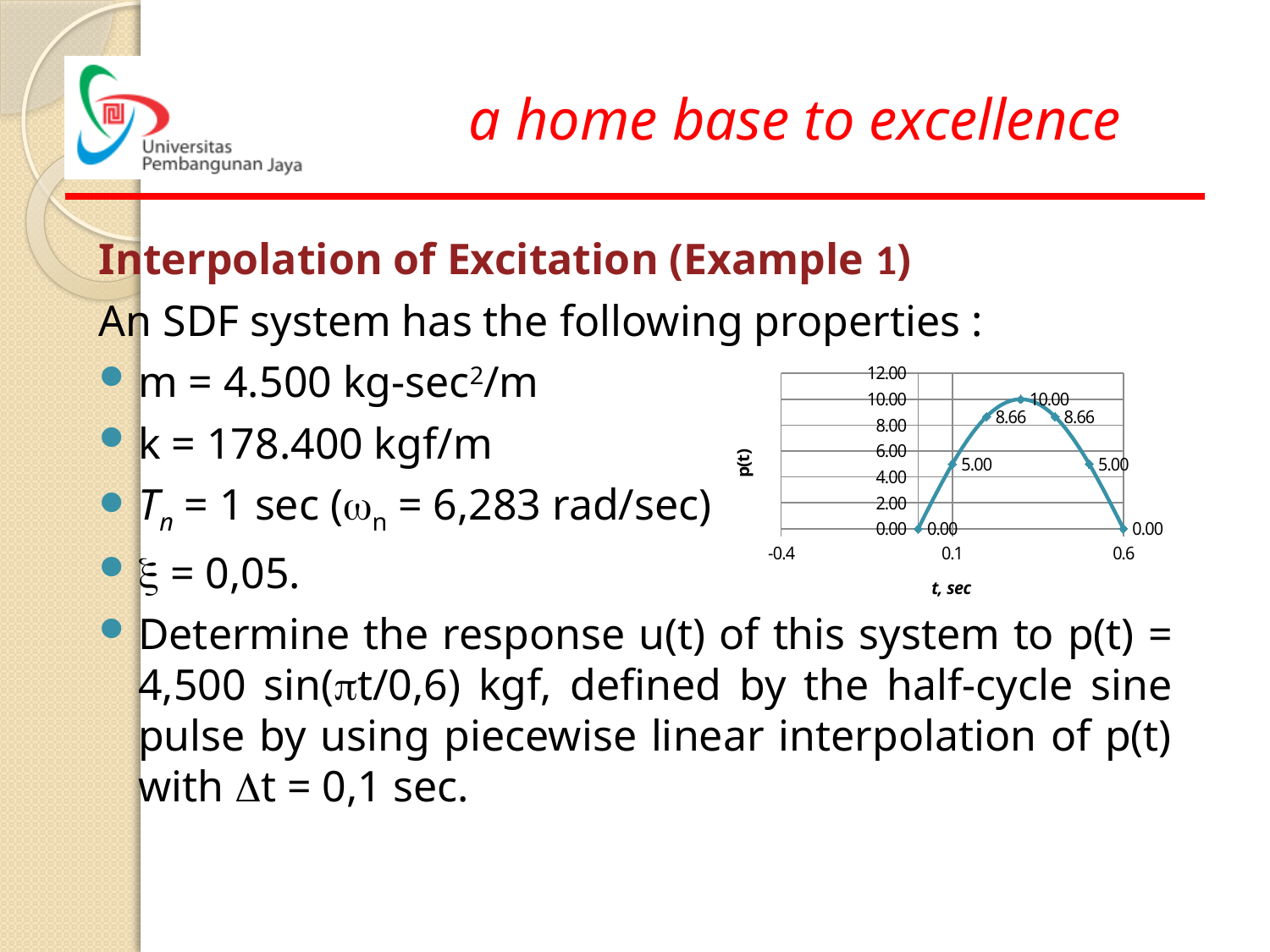
How does p(t) change along the x axis from left to right? rises to a peak then falls What is the difference between the peak value 10.00 and the neighbouring labelled value 8.66? 1.34 What is the label of the horizontal axis of the chart? t, sec What is the highest tick value shown on the vertical axis? 12.00 How many data points are plotted on the chart? 7 What is the difference between the labelled values 8.66 and 5.00? 3.66 What is the label of the vertical axis of the chart? p(t) Which is larger, the labelled value 8.66 or the labelled value 5.00? 8.66 What is the highest value labelled on the chart? 10.00 Is the peak value of the curve greater or less than 8.00? greater What kind of chart is shown on the slide? line chart What is the lowest value labelled on the chart? 0.00